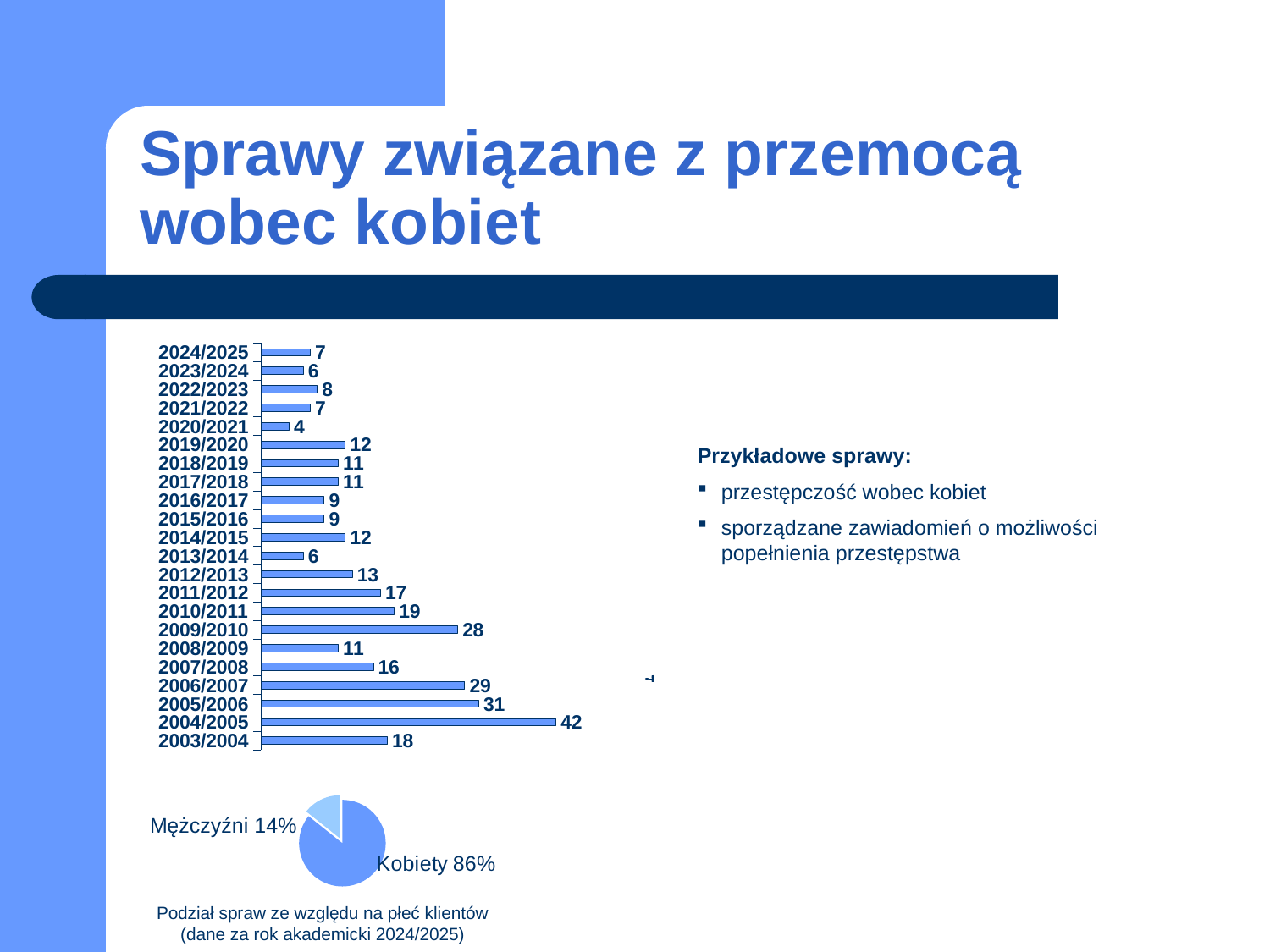
In the bar chart on the left, what is the value for 2004/2005? 42 How many slices does the pie chart at the bottom left have? 2 In the bar chart on the left, what is the value for 2020/2021? 4 In the bar chart on the left, which academic year has the lowest value? 2020/2021 In the bar chart on the left, which academic year has the highest value? 2004/2005 In the bar chart on the left, what is the difference between the values for 2005/2006 and 2006/2007? 2 In the bar chart on the left, what is the value for 2009/2010? 28 In the pie chart at the bottom left, what share is labelled Mężczyźni? 14% In the bar chart on the left, which is larger, the value for 2010/2011 or the value for 2011/2012? 2010/2011 What kind of chart is the chart at the top left of the slide? bar chart How many academic years are shown in the bar chart on the left? 22 In the pie chart at the bottom left, what share is labelled Kobiety? 86%